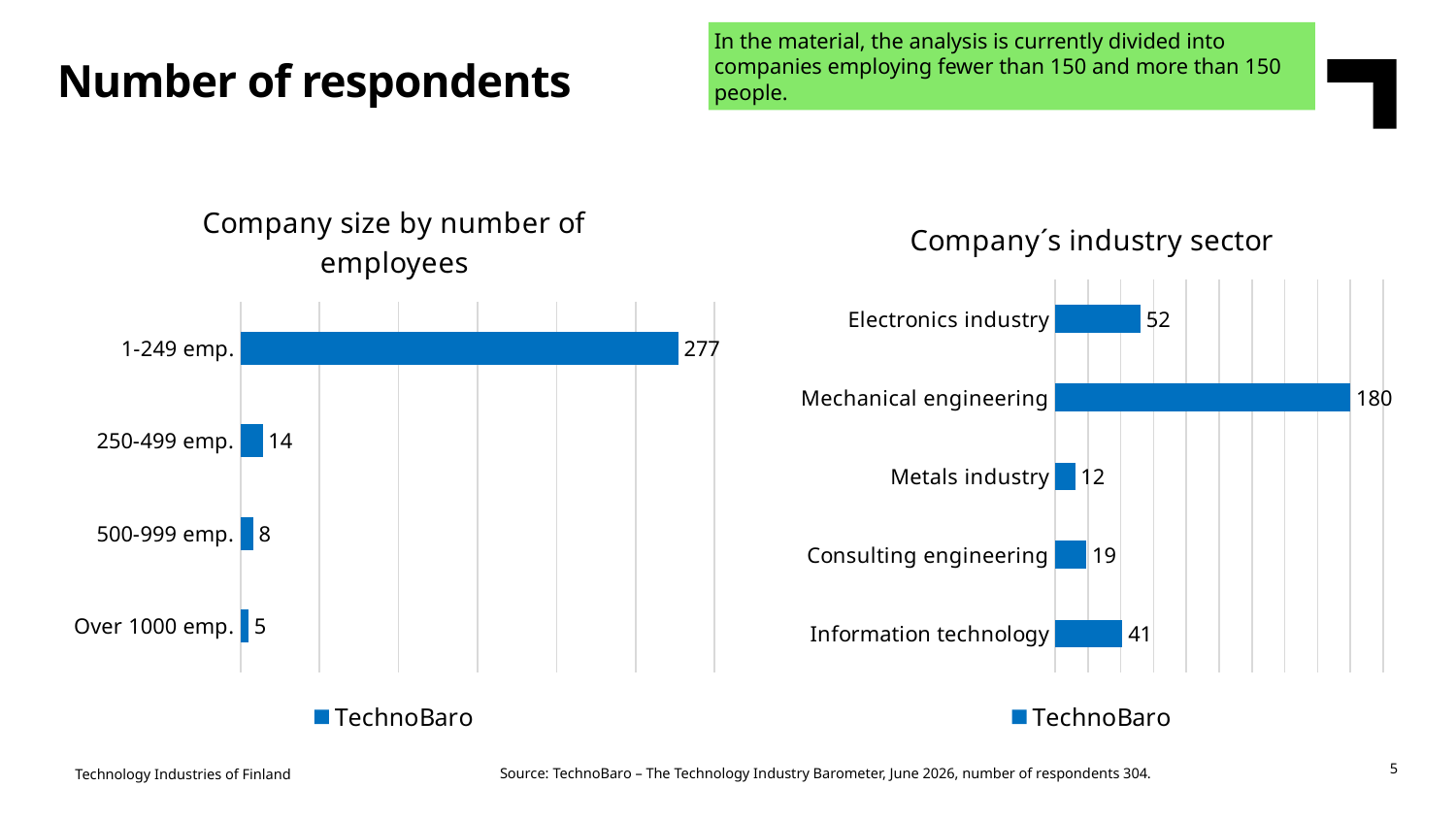
In the 'Company´s industry sector' chart, which category has the lowest value? Metals industry In the 'Company´s industry sector' chart, which is larger, Electronics industry or Information technology? Electronics industry In the 'Company size by number of employees' chart, which category has the lowest value? Over 1000 emp. In the 'Company´s industry sector' chart, what is the value for Consulting engineering? 19 In the 'Company size by number of employees' chart, what is the difference between the values for 250-499 emp. and Over 1000 emp.? 9 In the 'Company´s industry sector' chart, what is the value for Electronics industry? 52 What kind of chart is the 'Company´s industry sector' chart? Bar chart In the 'Company size by number of employees' chart, what is the value for 1-249 emp.? 277 In the 'Company´s industry sector' chart, what is the difference between the values for Mechanical engineering and Information technology? 139 In the 'Company´s industry sector' chart, which category has the highest value? Mechanical engineering In the 'Company size by number of employees' chart, how many categories are shown? 4 In the 'Company size by number of employees' chart, what is the value for 500-999 emp.? 8